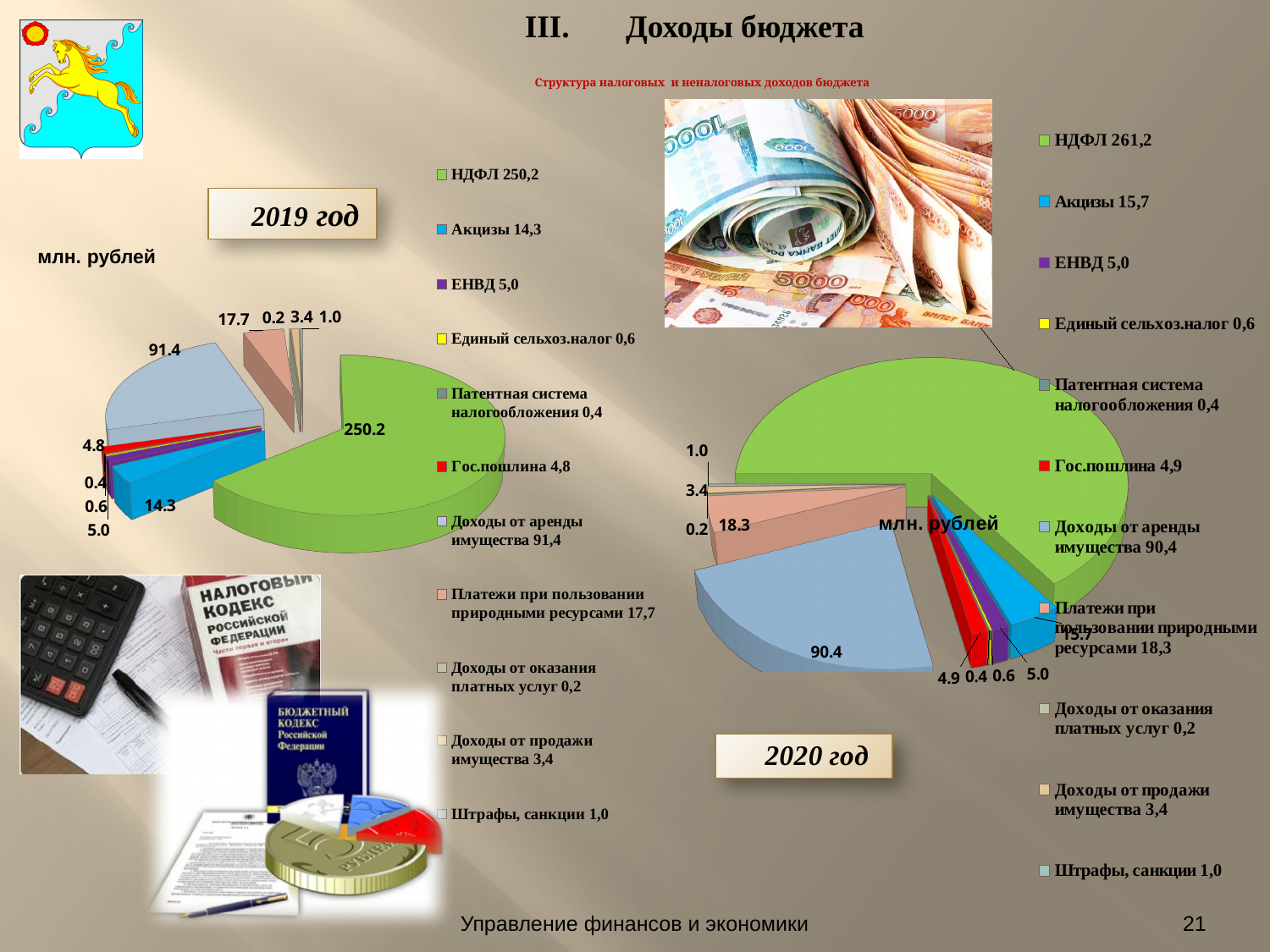
What unit is stated for the values in the 2019 год pie chart? млн. рублей In the 2020 год pie chart, which category has the smallest value? Доходы от оказания платных услуг Which chart shows a larger value for НДФЛ, the 2019 год chart or the 2020 год chart? 2020 год In the 2019 год pie chart, which category has the largest value? НДФЛ In the 2020 год pie chart, which is larger: Акцизы or ЕНВД? Акцизы What kind of chart is used for the 2020 год data? Pie chart In the 2019 год pie chart, what is the value for Гос.пошлина? 4.8 How many categories does the legend of the 2019 год pie chart list? 11 In the 2019 год pie chart, what is the difference between Доходы от аренды имущества and Платежи при пользовании природными ресурсами? 73.7 In the 2020 год pie chart, what is the value for Акцизы? 15.7 In the 2019 год pie chart, what is the value for НДФЛ? 250.2 In the 2020 год pie chart, what is the value for Доходы от аренды имущества? 90.4